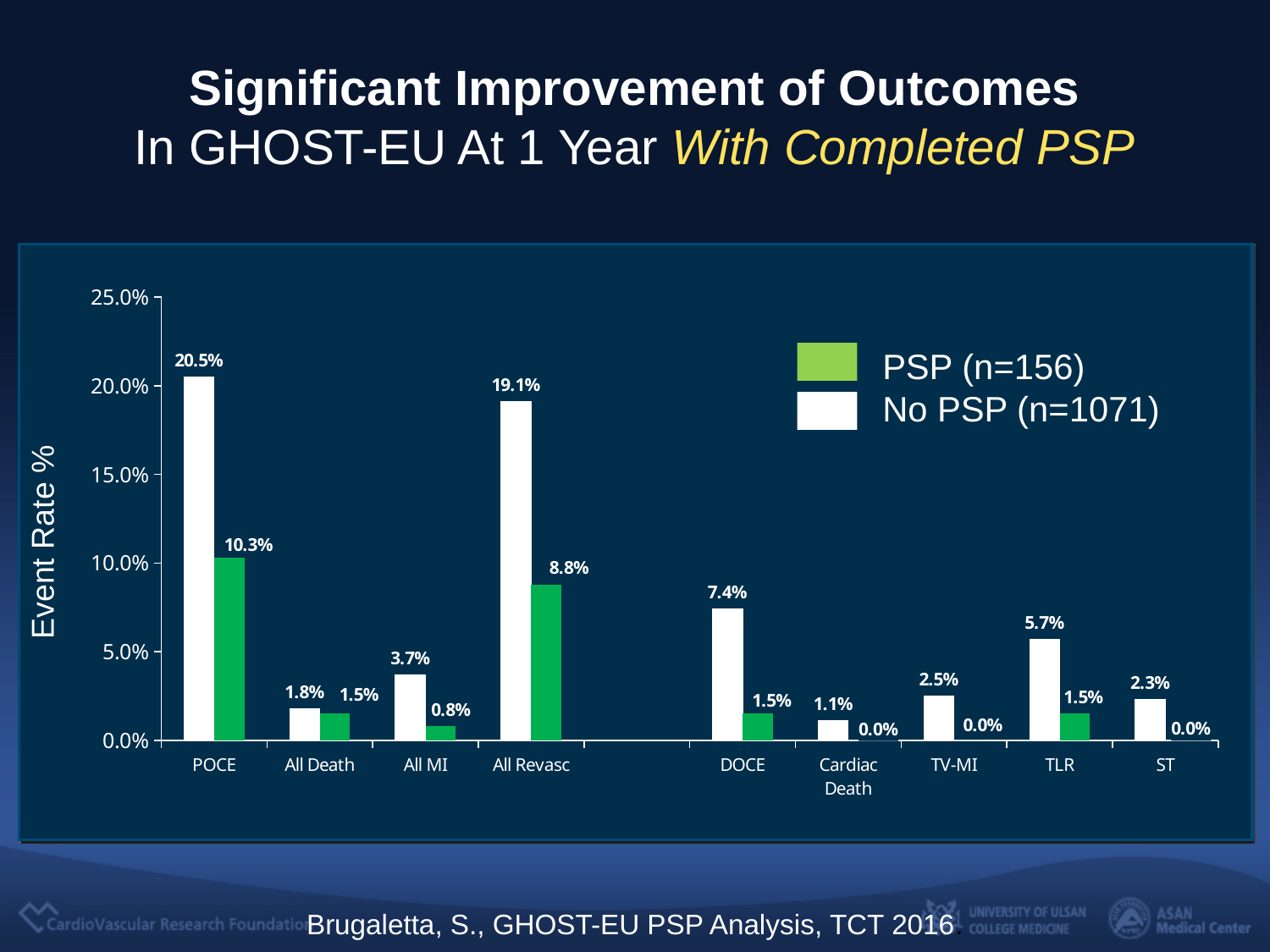
What is the difference between the No PSP and PSP event rates for POCE? 10.2% What kind of chart is shown on the slide? bar chart How many series does the legend list? 2 Which category has the lowest No PSP event rate? Cardiac Death What is the difference between the No PSP and PSP event rates for DOCE? 5.9% What is the No PSP event rate for POCE? 20.5% Which category has the highest No PSP event rate? POCE Is the No PSP event rate for All Revasc greater or less than 15.0%? greater What is the PSP event rate for TLR? 1.5% What is the PSP event rate for All Revasc? 8.8% Which is larger, the No PSP event rate for All MI or the No PSP event rate for TV-MI? All MI How many categories are shown on the x axis? 9